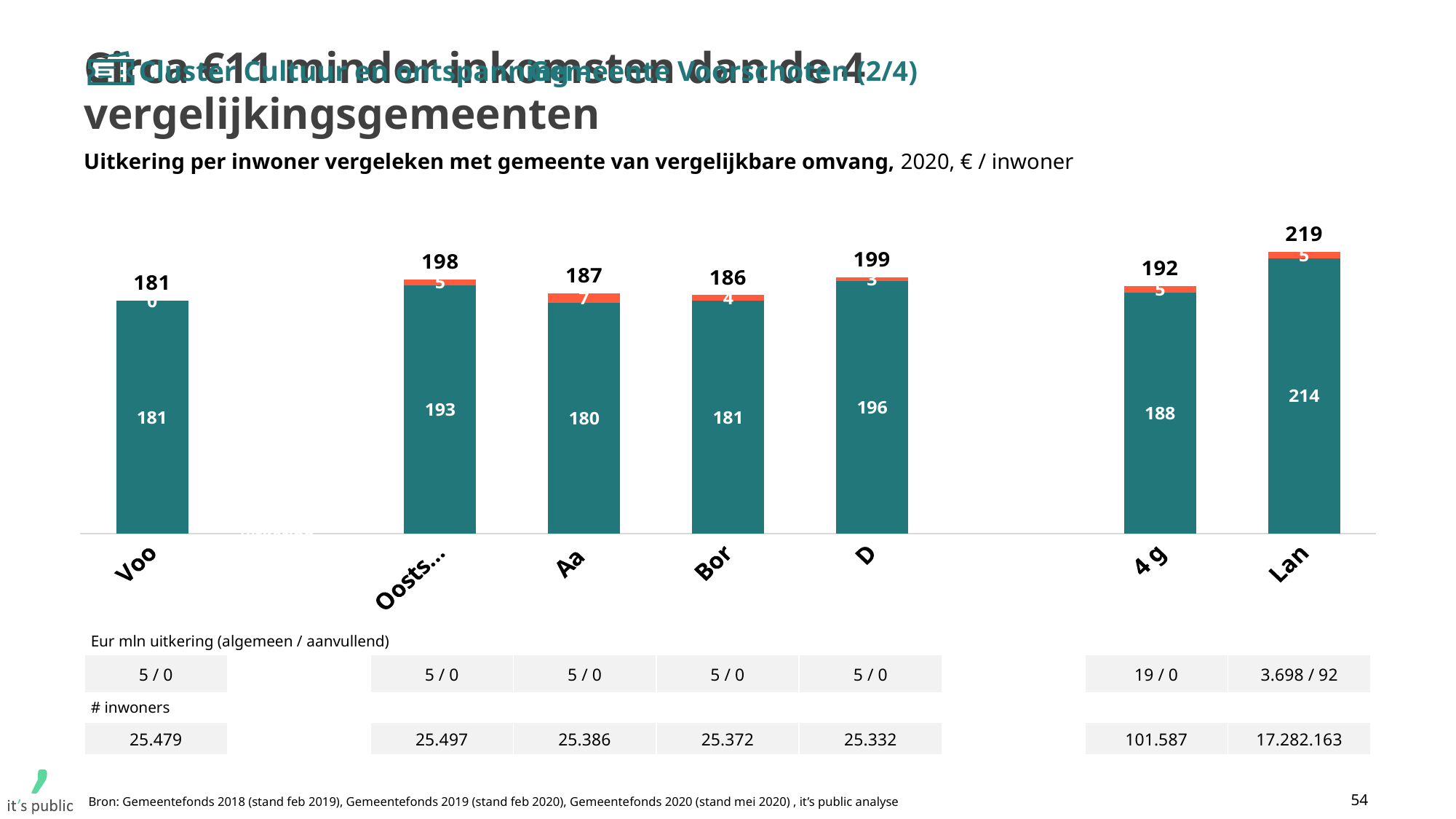
What is the value of the orange (upper) segment of the bar for Aa? 7 What is the value of the teal (lower) segment of the bar for D? 196 What is the difference between the total for Lan and the total for Voo? 38 Which category has the highest total value? Lan How many bars are plotted in the chart? 7 Which category has the lowest total value? Voo What is the total value shown above the bar for Voo? 181 What type of chart is shown on the slide? Stacked bar chart Which has a larger total, D or Bor? D What unit is stated in the chart subtitle for the plotted values? € / inwoner What is the sum of the two segments of the bar for 4 g (188 and 5)? 193 What is the total value shown above the bar for Lan? 219